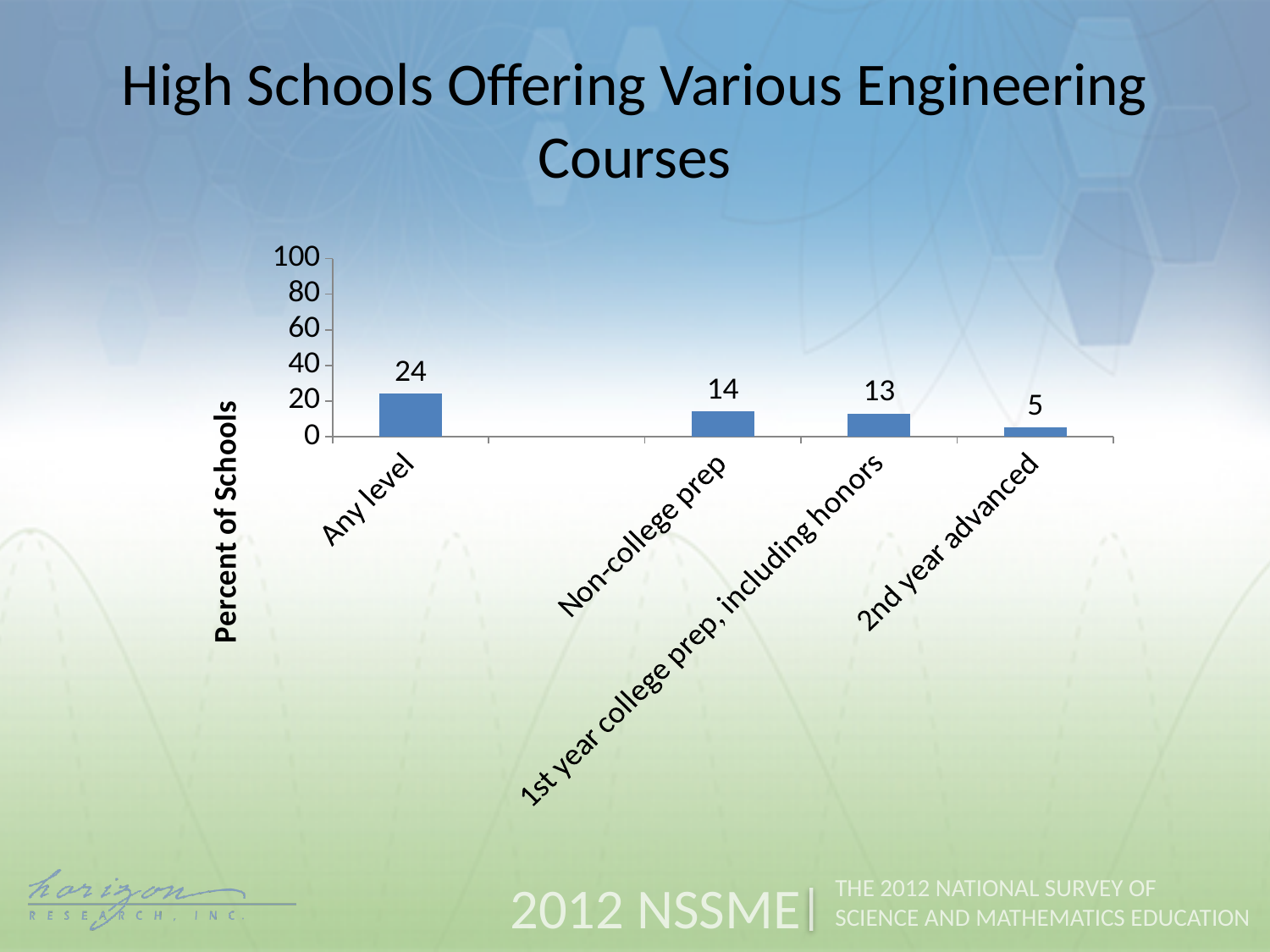
What kind of chart is shown on the slide? bar chart What is the value for Non-college prep? 14 What is the value for 1st year college prep, including honors? 13 What is the difference between the values for Non-college prep and 1st year college prep, including honors? 1 How many categories are shown on the x axis? 4 What percent of high schools offer engineering courses at any level? 24 What is the difference between the values for Any level and 2nd year advanced? 19 Which category has the lowest value? 2nd year advanced Which is larger, the value for Non-college prep or the value for 2nd year advanced? Non-college prep Which category has the highest value? Any level What is the value for 2nd year advanced? 5 Is the value for Any level greater or less than 20? greater